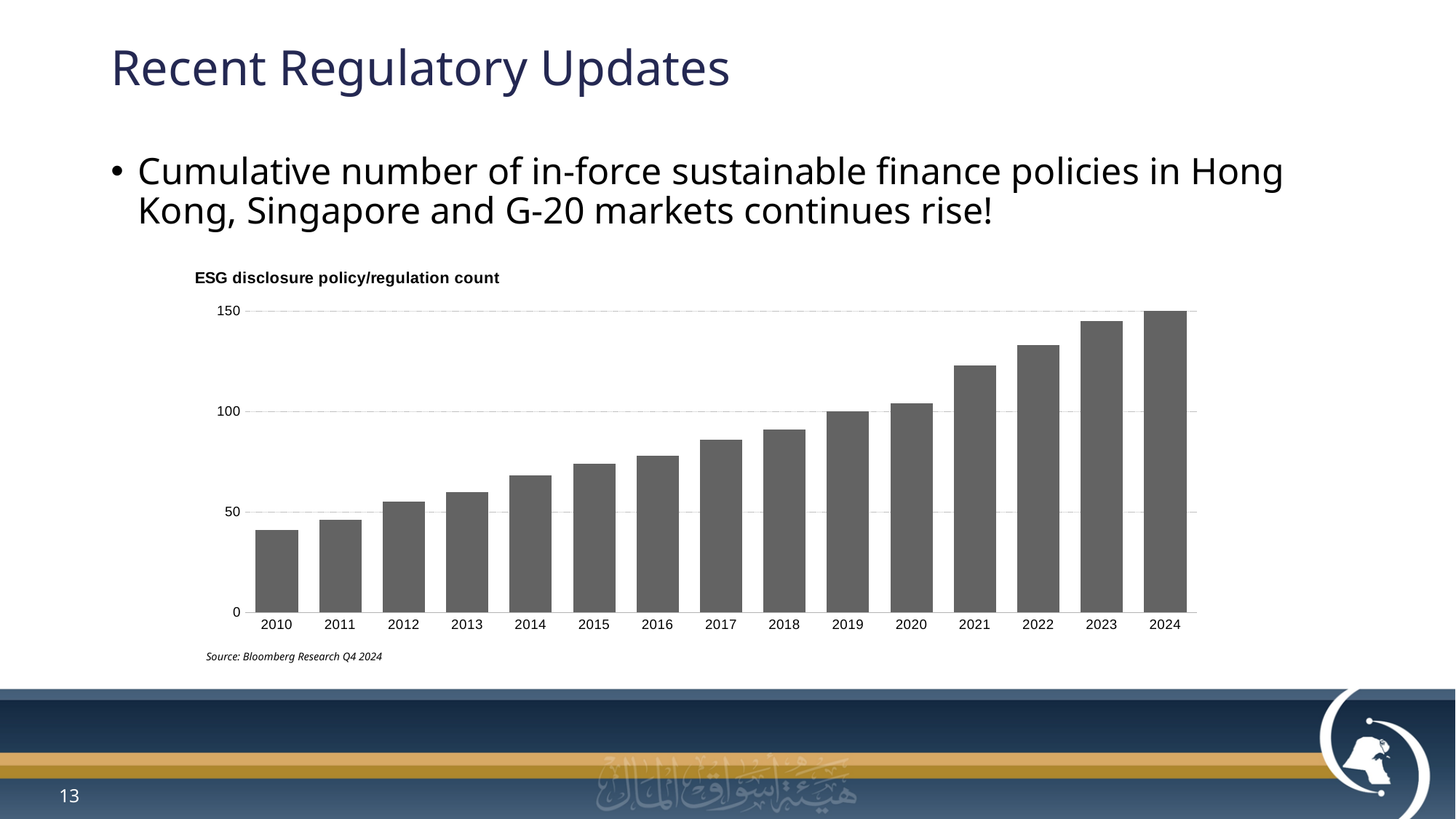
Do the values rise or fall from 2010 to 2024? rise Is the value for 2010 greater or less than 50? less Which is larger, the value for 2015 or the value for 2022? 2022 What source is cited below the chart? Bloomberg Research Q4 2024 Is the value for 2013 greater or less than 50? greater What kind of chart is shown on the slide? bar chart Which year has the lowest ESG disclosure policy/regulation count? 2010 Is the value for 2021 greater or less than 100? greater Which year has the highest ESG disclosure policy/regulation count? 2024 How many years are shown on the x axis of the chart? 15 What is the title of the chart? ESG disclosure policy/regulation count